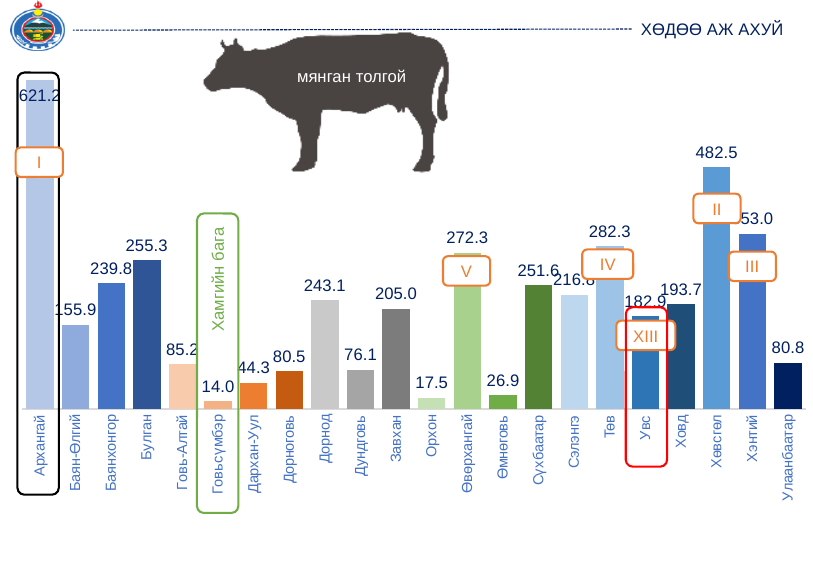
Which is larger, the value for Төв or the value for Сүхбаатар? Төв Which category has the lowest value? Говьсүмбэр What is the value for Архангай? 621.2 What is the value for Хөвсгөл? 482.5 How many categories are shown in the chart? 22 What is the difference between the values for Ховд and Увс? 10.8 What kind of chart is shown on the slide? Bar chart What is the value for Говьсүмбэр? 14.0 What is the value for Өвөрхангай? 272.3 Which category has the highest value? Архангай Which is larger, the value for Булган or the value for Баянхонгор? Булган What is the difference between the values for Архангай and Хөвсгөл? 138.7